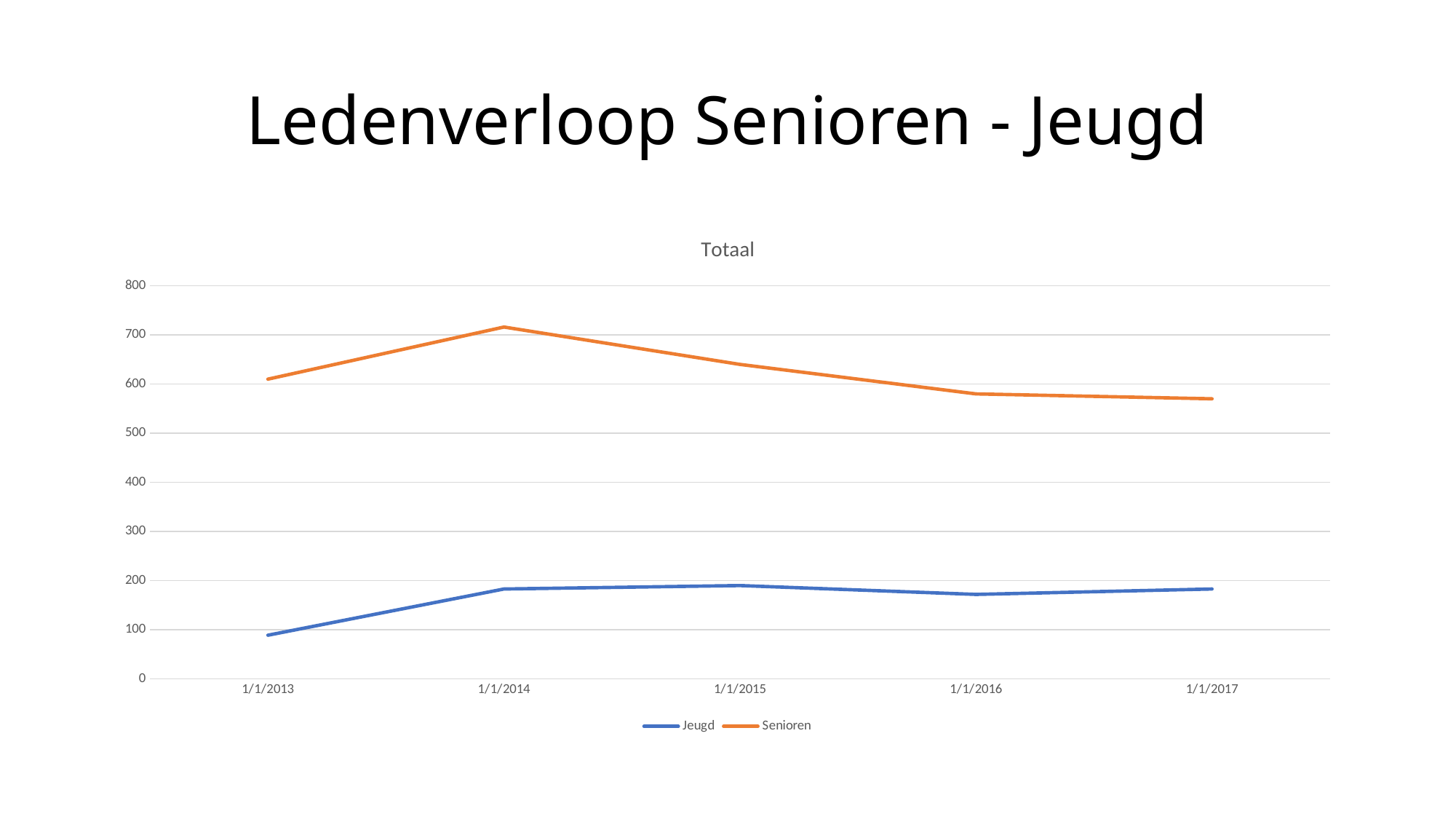
On which date does the Jeugd series have its lowest value? 1/1/2013 Is the value for Senioren on 1/1/2017 greater or less than 500? greater What kind of chart is shown on the slide? line chart How many dates are shown on the x axis? 5 Does the Senioren series rise or fall from 1/1/2014 to 1/1/2017? fall How many series does the legend list? 2 On which date does the Senioren series reach its highest value? 1/1/2014 Is the value for Jeugd on 1/1/2013 greater or less than 100? less What is the title shown above the chart? Totaal Is the value for Senioren on 1/1/2014 greater or less than 700? greater Which series has the larger value on 1/1/2015, Jeugd or Senioren? Senioren Which series is drawn in orange? Senioren